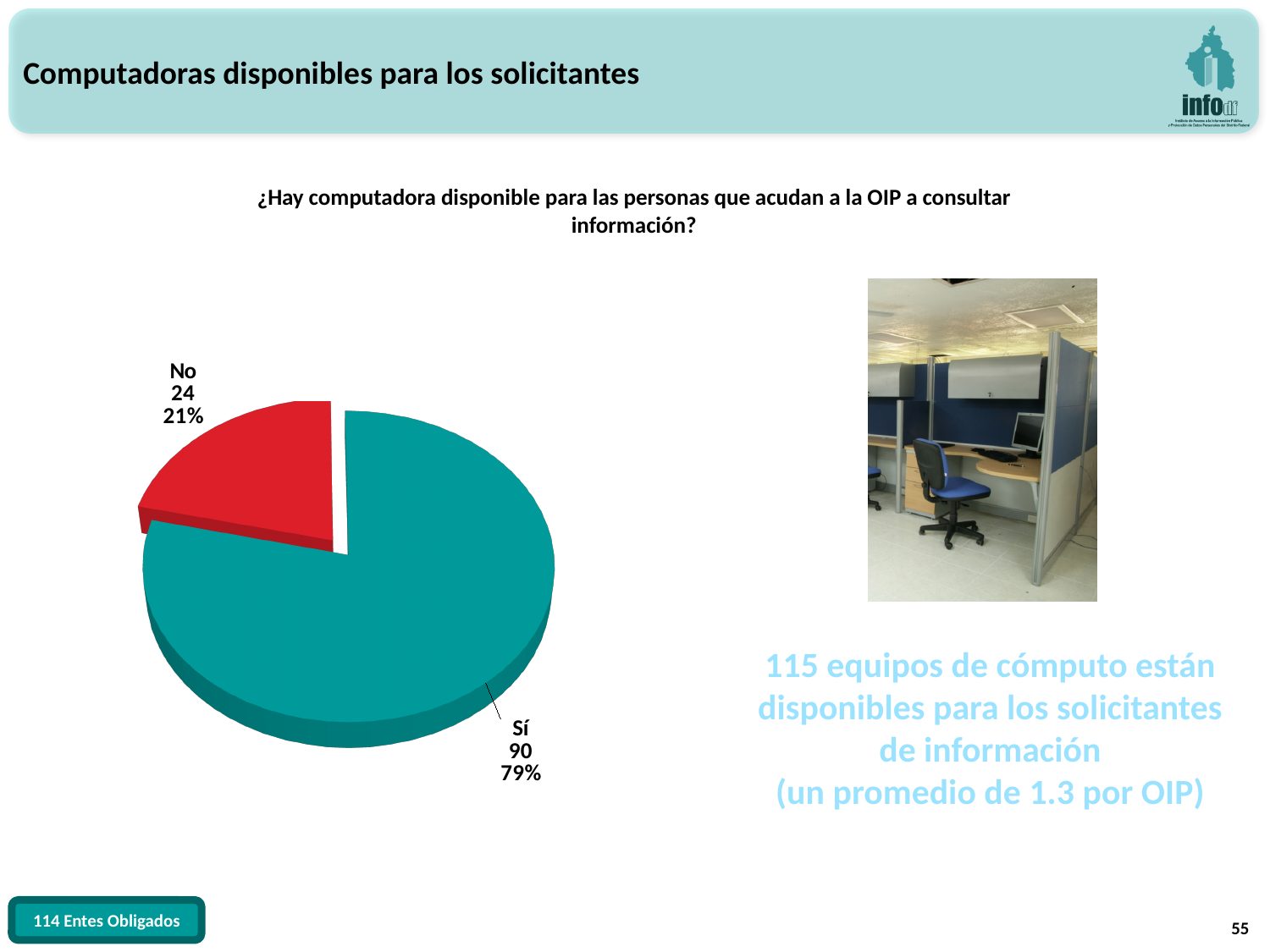
Which is larger, the value for "Sí" or the value for "No"? Sí Which slice is the largest? Sí What is the total of the two slices in the pie chart? 114 What colour is the "No" slice? red How many slices does the pie chart have? 2 What share of the pie does the "Sí" slice represent? 79% What is the value for the "No" slice? 24 What kind of chart is shown on the slide? pie chart Which slice is the smallest? No What is the value for the "Sí" slice? 90 What share of the pie does the "No" slice represent? 21% What is the difference between the "Sí" and "No" values? 66